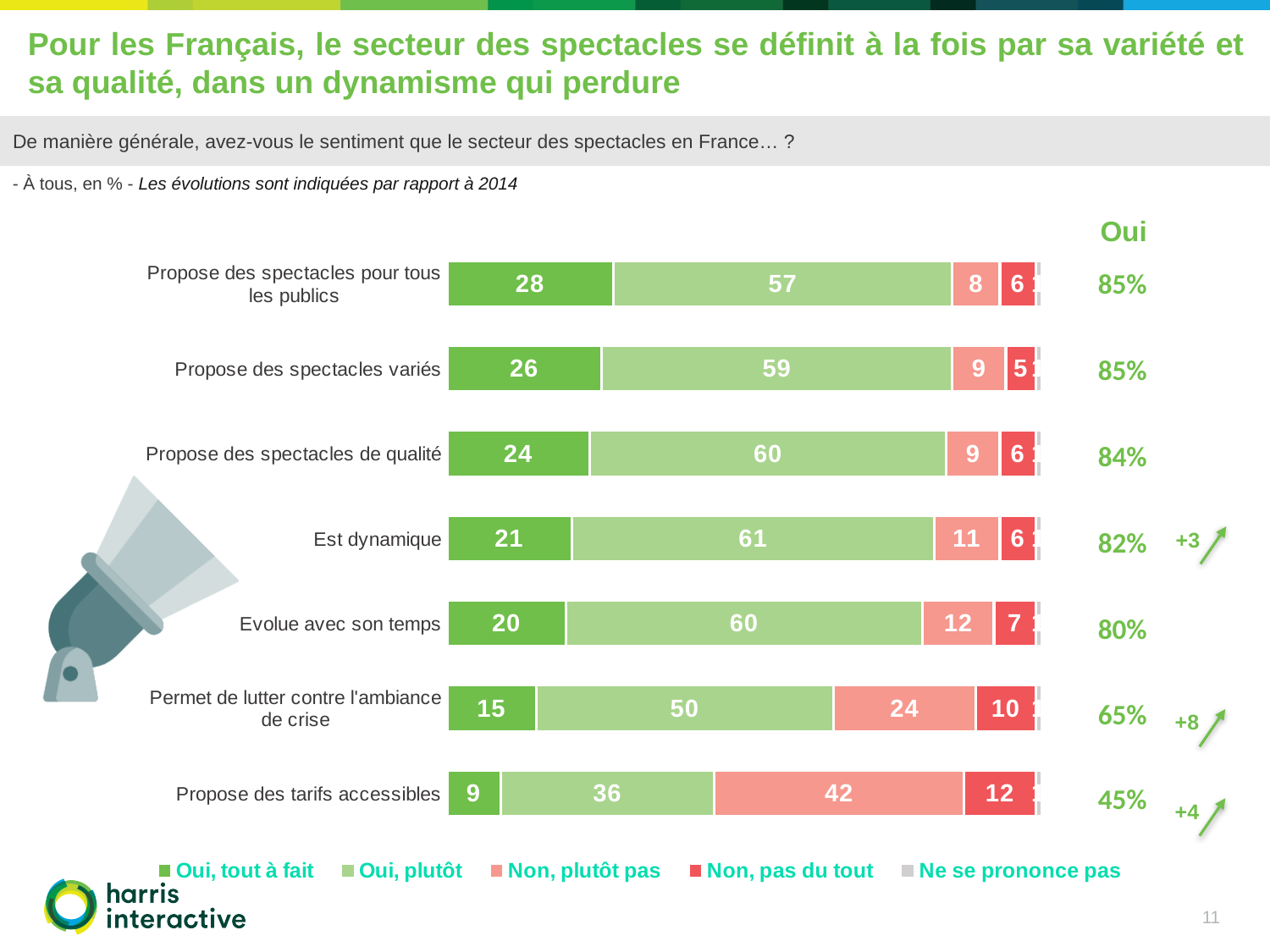
What is the value of "Oui, tout à fait" for "Propose des spectacles pour tous les publics"? 28 Which category has the highest "Oui, tout à fait" value? Propose des spectacles pour tous les publics How many categories are shown in the chart? 7 What is the value of "Non, plutôt pas" for "Propose des tarifs accessibles"? 42 Which category has the lowest "Oui, tout à fait" value? Propose des tarifs accessibles What is the value of "Oui, plutôt" for "Est dynamique"? 61 What is the combined total of "Oui, tout à fait" and "Oui, plutôt" for "Propose des tarifs accessibles"? 45 What is the difference between the "Oui, plutôt" values for "Propose des spectacles variés" and "Propose des tarifs accessibles"? 23 What kind of chart is shown on the slide? Stacked bar chart How many series does the legend list? 5 What is the "Oui" total shown for "Permet de lutter contre l'ambiance de crise"? 65% Which has the larger "Non, plutôt pas" value: "Permet de lutter contre l'ambiance de crise" or "Evolue avec son temps"? Permet de lutter contre l'ambiance de crise